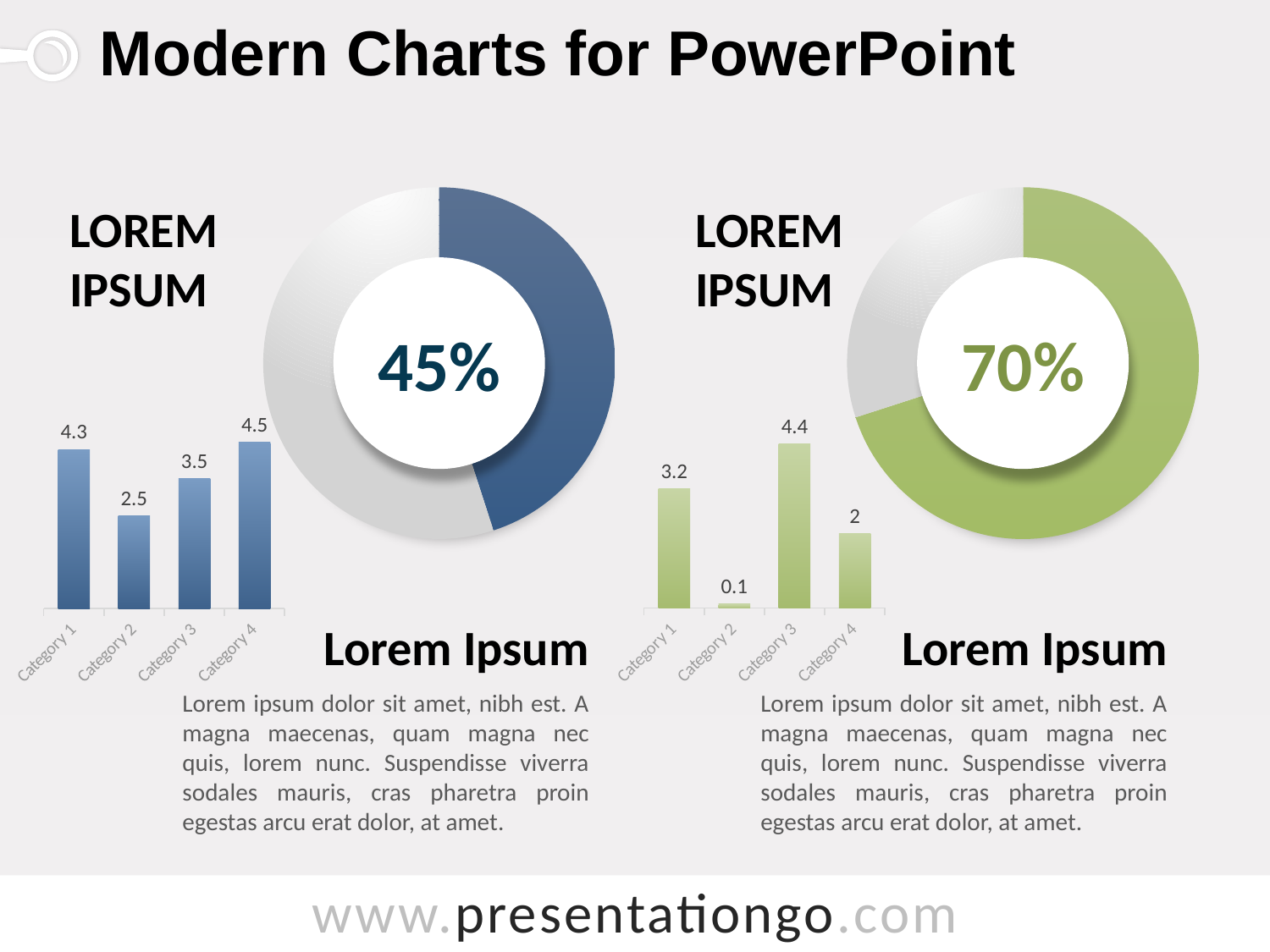
What kind of chart is the green chart on the right that displays 70%? Donut chart In the green bar chart on the right, which category has the lowest value? Category 2 In the blue bar chart on the left, what is the value for Category 2? 2.5 What kind of chart is the blue chart on the left showing Category 1 to Category 4? Bar chart In the green bar chart on the right, what is the difference between the values for Category 1 and Category 4? 1.2 What percentage is shown in the centre of the green donut chart on the right? 70% In the green bar chart on the right, what is the value for Category 3? 4.4 In the blue bar chart on the left, what is the difference between the values for Category 4 and Category 2? 2 In the blue bar chart on the left, which category has the highest value? Category 4 In the blue bar chart on the left, which is larger, the value for Category 1 or the value for Category 3? Category 1 What percentage is shown in the centre of the blue donut chart on the left? 45% How many categories does the green bar chart on the right show? 4